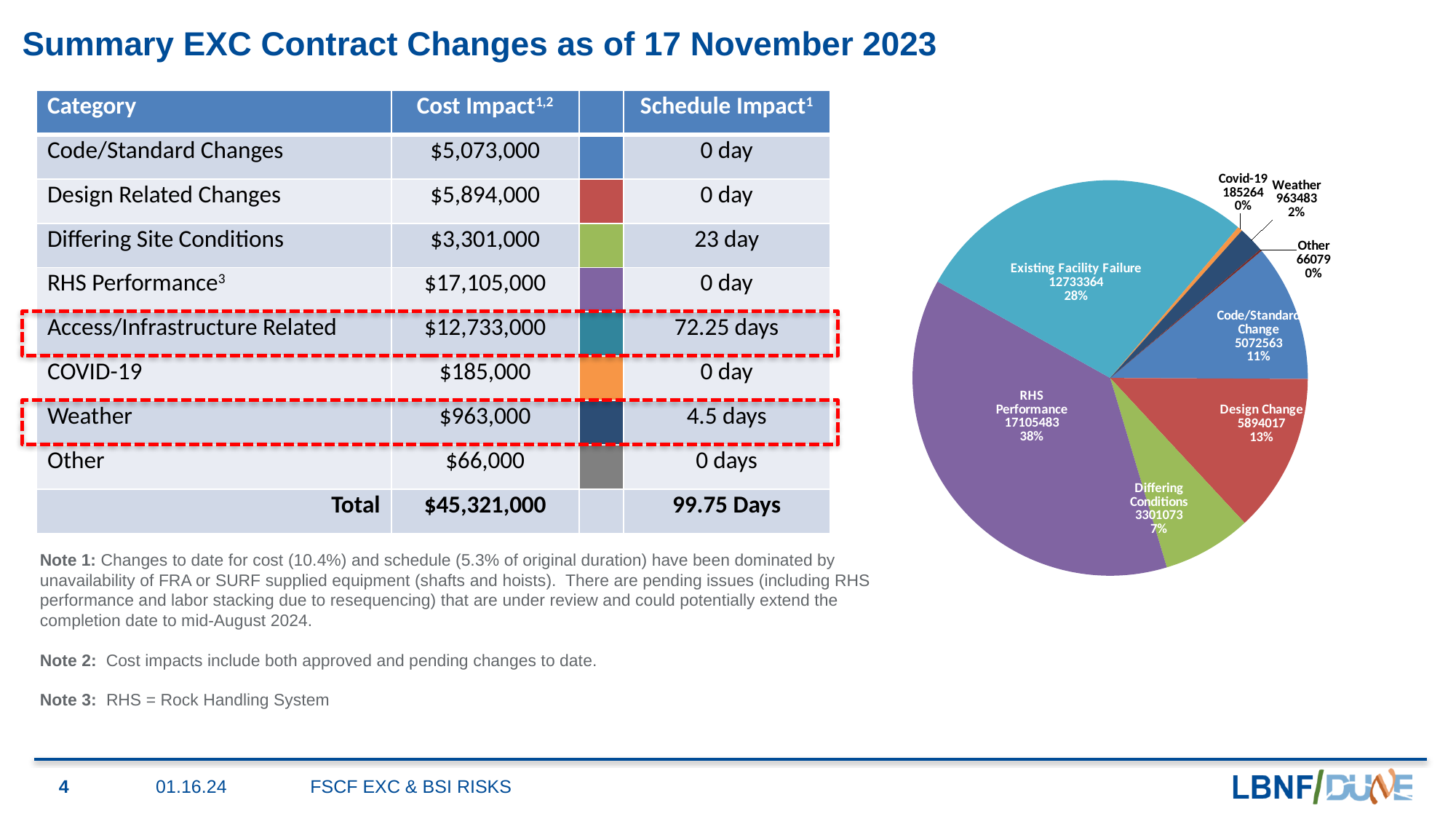
What value is labelled on the Weather slice of the pie chart? 963483 In the pie chart, which is larger: Design Change or Code/Standard Change? Design Change Which slice of the pie chart is the smallest? Other In the pie chart, what is the difference between the RHS Performance value and the Existing Facility Failure value? 4372119 What value is labelled on the Existing Facility Failure slice of the pie chart? 12733364 How many slices does the pie chart have? 8 What colour is the RHS Performance slice in the pie chart? purple What percentage share does the RHS Performance slice have in the pie chart? 38% What percentage share does the Differing Conditions slice have in the pie chart? 7% What value is labelled on the RHS Performance slice of the pie chart? 17105483 Which slice of the pie chart is the largest? RHS Performance What kind of chart is shown on the right side of the slide? pie chart